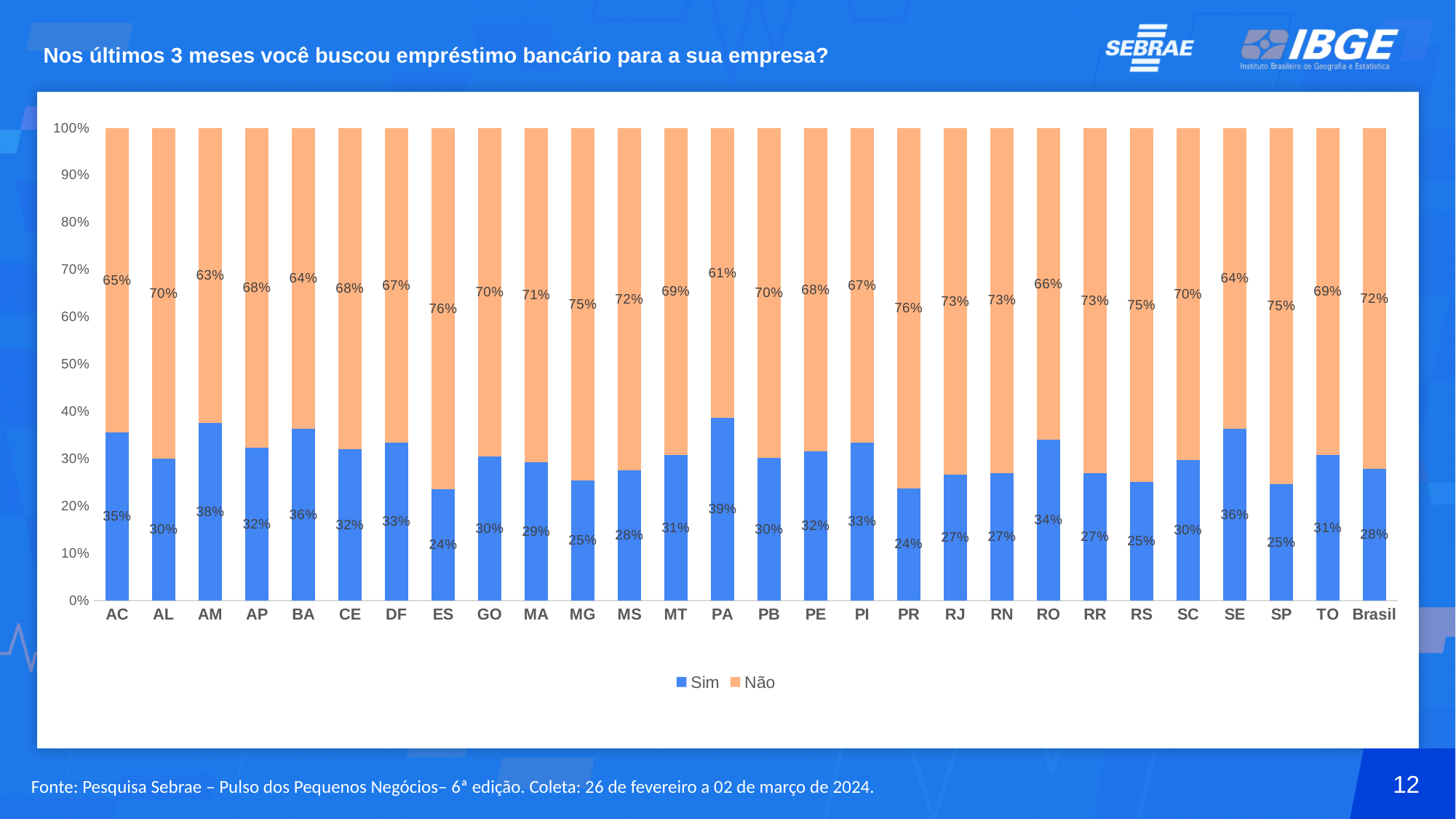
Which has a larger "Sim" value, RO or MG? RO What type of chart is shown on the slide? Stacked bar chart Which category has the lowest "Não" percentage? PA What percentage of respondents in PA answered "Sim"? 39% What is the total of the stacked bar for DF? 100% How many categories are shown on the x axis? 28 What is the "Não" value for Brasil? 72% Which category has the highest "Sim" percentage? PA How many series does the legend list? 2 What is the "Sim" value for SE? 36% What is the difference between the "Sim" values for AM and ES? 14% Which colour represents the "Não" series? Orange